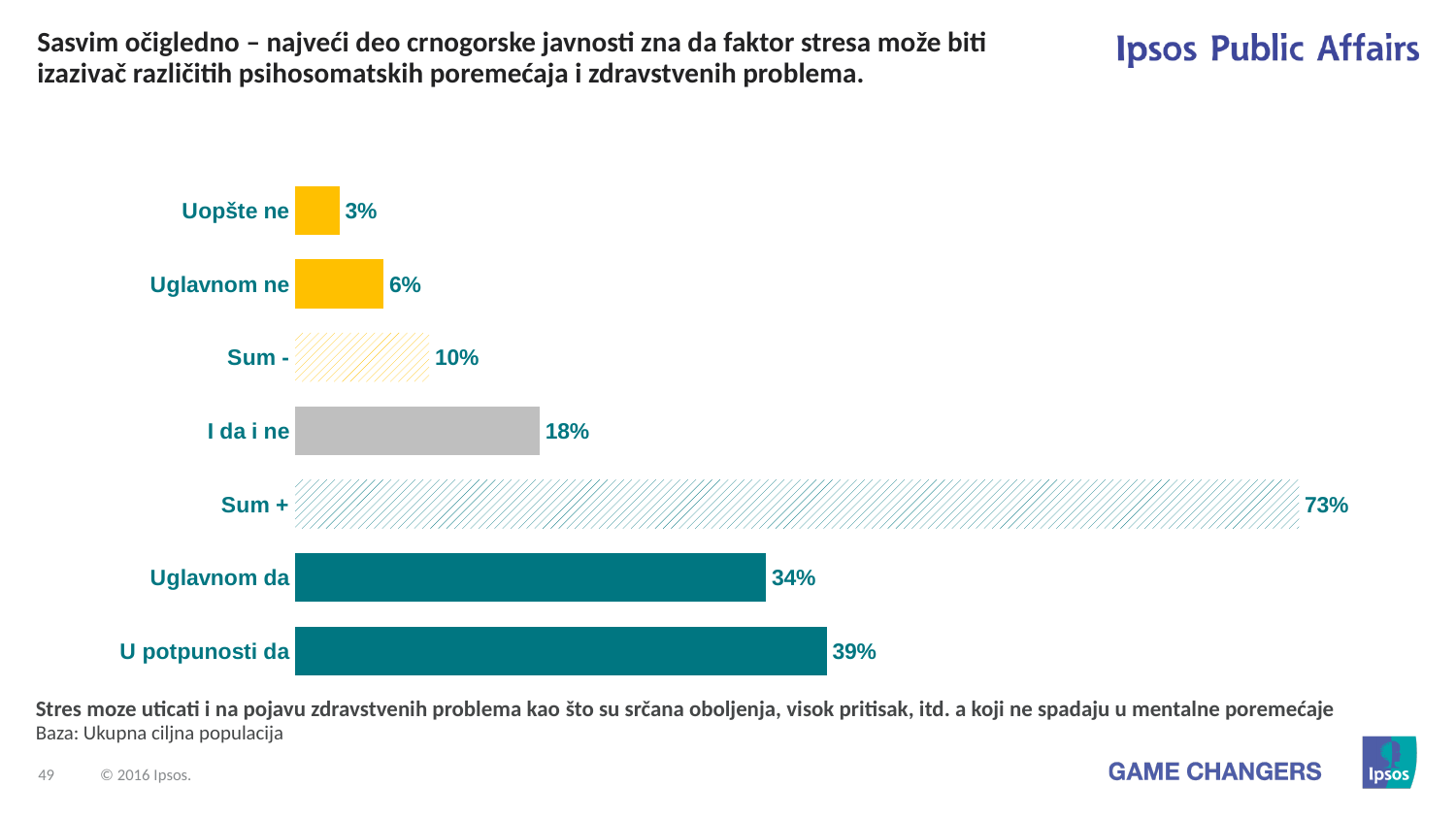
Which is larger, the value for "Uglavnom ne" or the value for "I da i ne"? I da i ne Which category has the lowest value? Uopšte ne How many categories are shown in the chart? 7 What is the value for "Sum +"? 73% What is the value for "I da i ne"? 18% What kind of chart is shown on the slide? Bar chart What is the value for "U potpunosti da"? 39% What is the difference between the values for "Sum +" and "Sum -"? 63% What is the value for "Uglavnom da"? 34% What is the difference between the values for "U potpunosti da" and "Uglavnom da"? 5% Which category has the highest value? Sum + What is the value for "Uopšte ne"? 3%